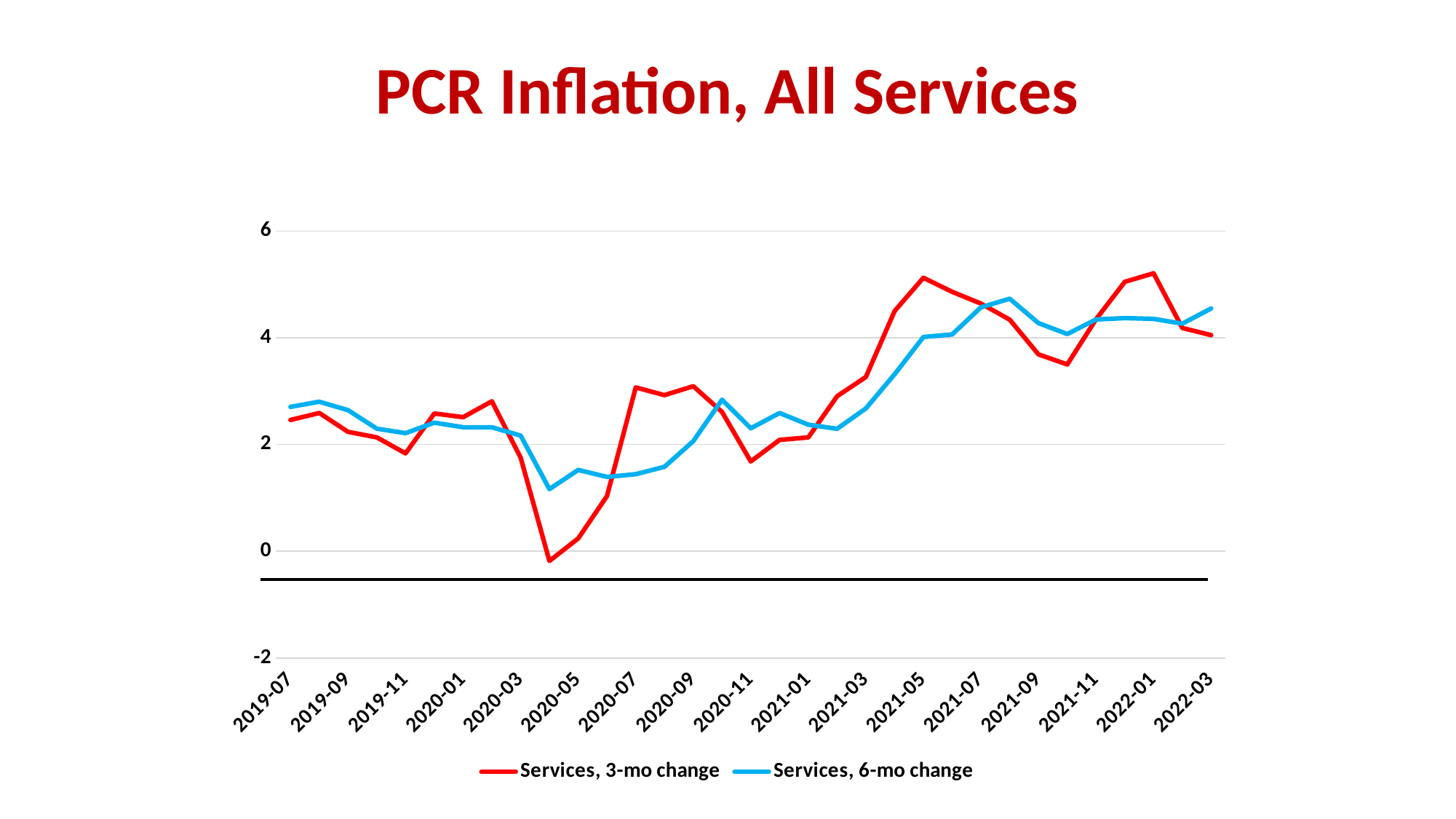
At 2020-07, which series has the larger value, 'Services, 3-mo change' or 'Services, 6-mo change'? Services, 3-mo change Is the value for 'Services, 3-mo change' at 2020-05 greater or less than 2? less Overall, do the values of 'Services, 6-mo change' rise or fall from 2019-07 to 2022-03? rise Which colour is used for the 'Services, 6-mo change' series? blue Is the value for 'Services, 6-mo change' at 2020-05 greater or less than 2? less Is the value for 'Services, 6-mo change' at 2022-03 greater or less than 4? greater At 2021-09, which series has the larger value, 'Services, 3-mo change' or 'Services, 6-mo change'? Services, 6-mo change What kind of chart is shown on the slide? line chart How many series does the legend list? 2 What is the title of the chart? PCR Inflation, All Services